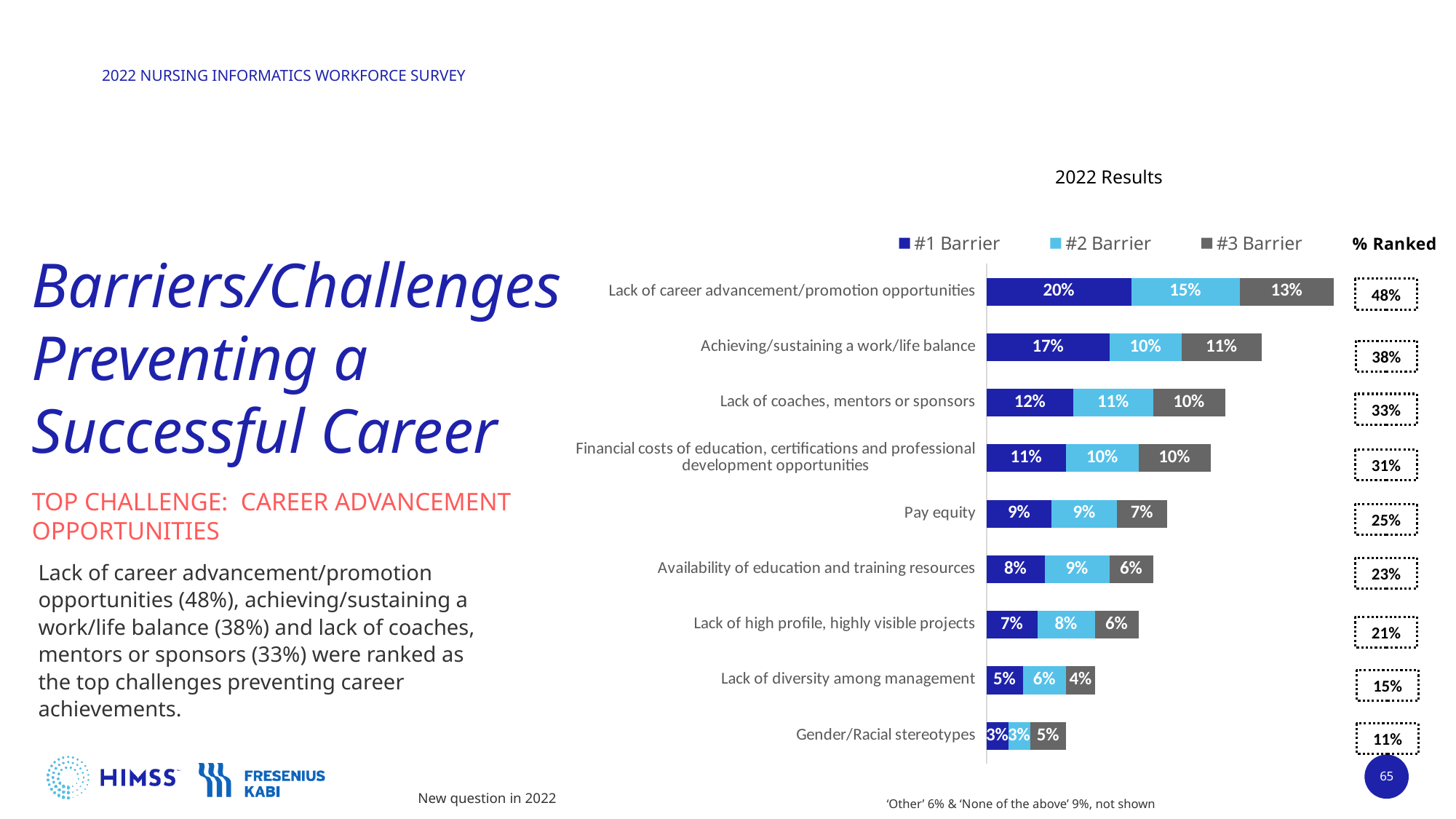
What is the #2 Barrier value for Achieving/sustaining a work/life balance? 10% What is the #1 Barrier value for Lack of career advancement/promotion opportunities? 20% Which category has the lowest #3 Barrier value? Lack of diversity among management What is the #3 Barrier value for Pay equity? 7% Which is larger: the #2 Barrier value for Lack of coaches, mentors or sponsors or the #2 Barrier value for Pay equity? Lack of coaches, mentors or sponsors How many categories are shown in the chart? 9 Which category has the highest #1 Barrier value? Lack of career advancement/promotion opportunities What is the total of the stacked bar for Lack of high profile, highly visible projects? 21% What kind of chart is shown on the slide? Stacked bar chart What is the title of the chart? 2022 Results How many series does the legend list? 3 What is the difference between the #1 Barrier values for Lack of career advancement/promotion opportunities and Achieving/sustaining a work/life balance? 3%